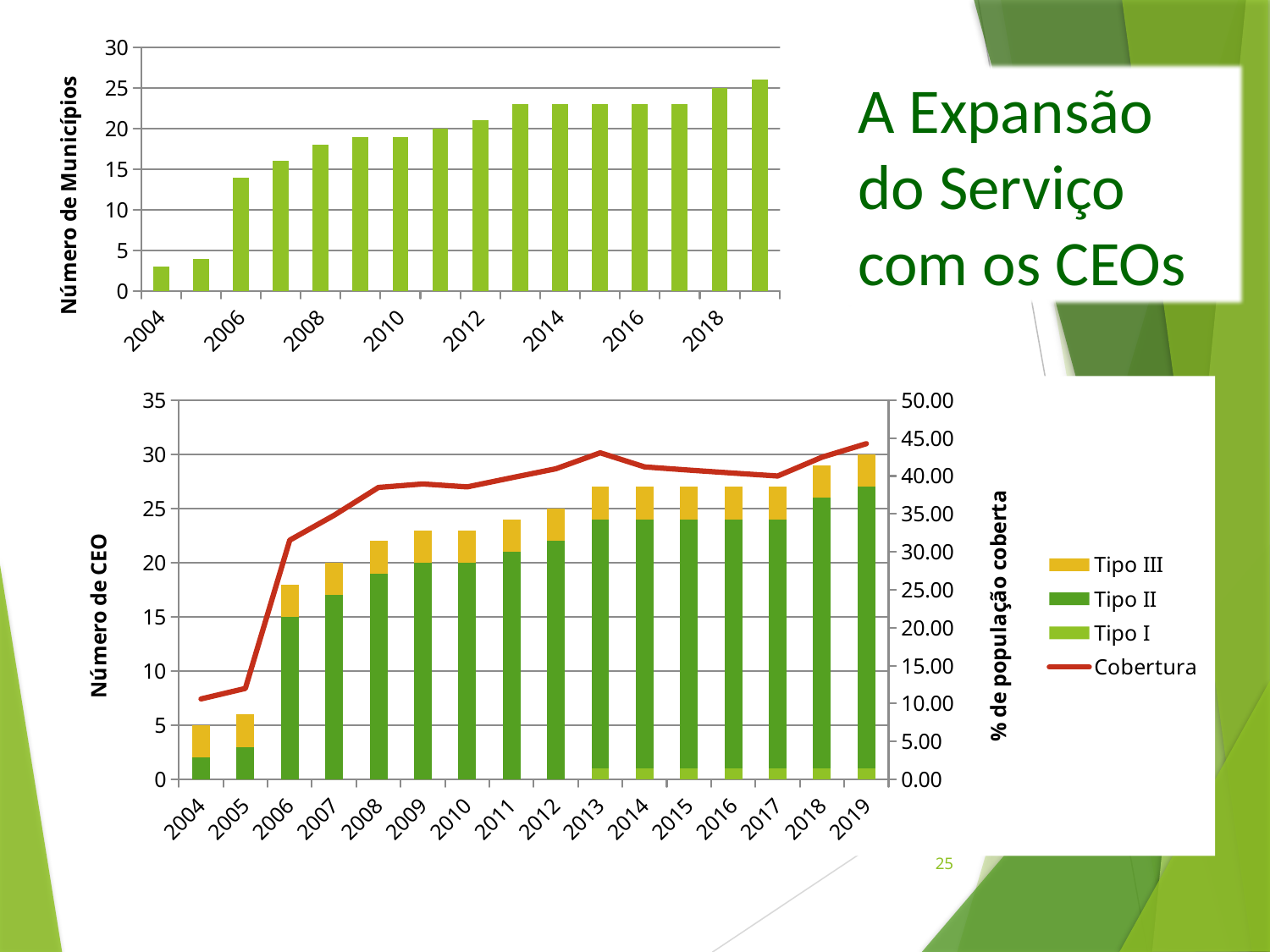
In the bottom chart (Número de CEO), which series is drawn as a line rather than bars? Cobertura In the bottom chart (Número de CEO), is the Cobertura value for 2004 greater or less than 15.00? less In the top chart (Número de Municípios), which year has the highest value? 2019 In the top chart (Número de Municípios), which year has the lowest value? 2004 In the top chart (Número de Municípios), do the values generally rise or fall from 2004 to 2019? rise In the bottom chart (Número de CEO), is the Cobertura value for 2019 greater or less than 40.00? greater In the top chart (Número de Municípios), is the value for 2006 greater or less than 10? greater What kind of chart is the top chart (Número de Municípios)? bar chart In the bottom chart (Número de CEO), how many series does the legend list? 4 In the bottom chart (Número de CEO), which year has a larger total number of CEOs, 2005 or 2006? 2006 In the top chart (Número de Municípios), how many bars are plotted? 16